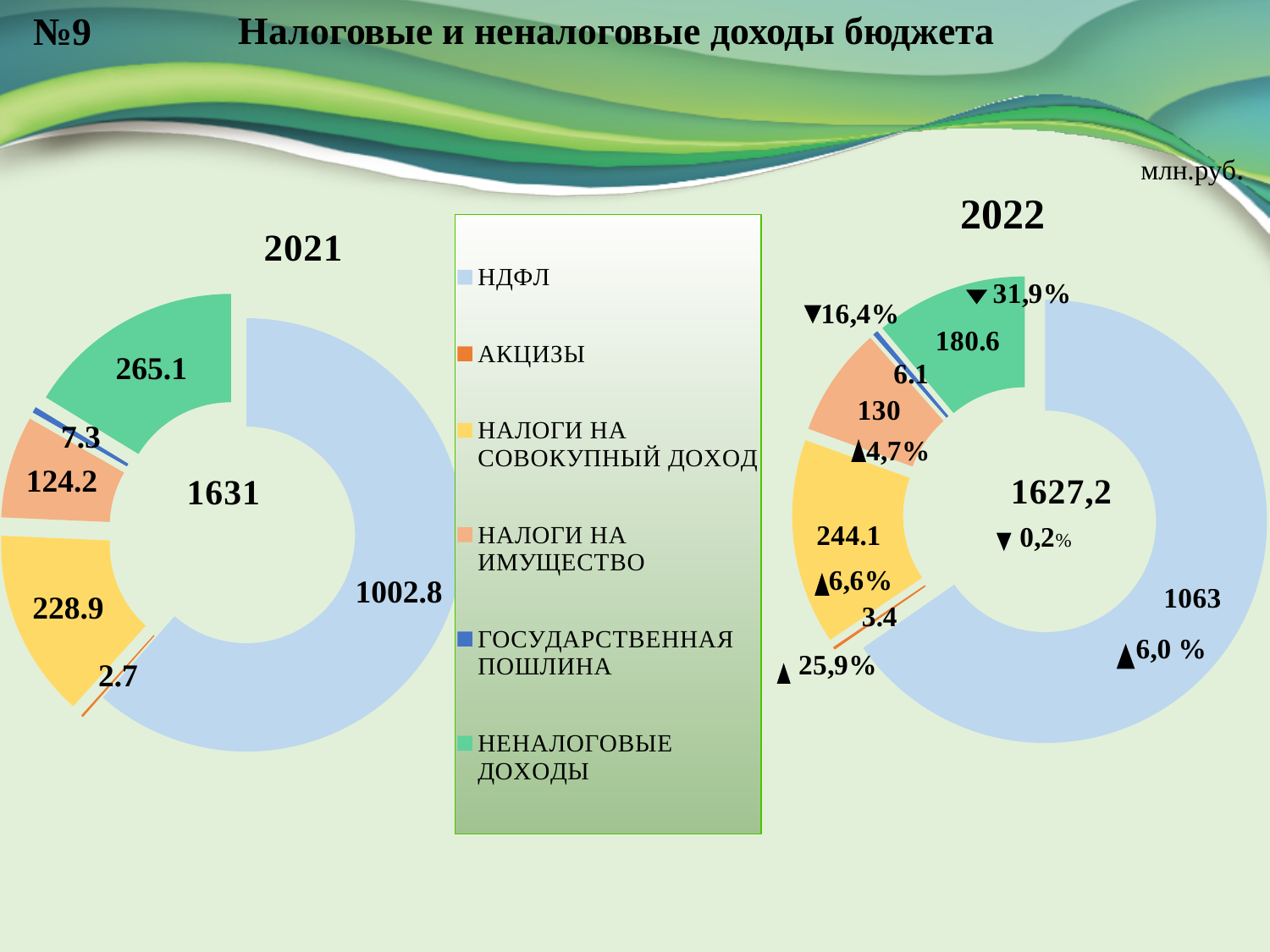
How many entries does the legend list? 6 What kind of chart is the 2021 chart? Doughnut chart On the 2022 chart, what is the value for НАЛОГИ НА СОВОКУПНЫЙ ДОХОД? 244.1 On the 2021 chart, what is the value for НДФЛ? 1002.8 On the 2022 chart, what is the value for НЕНАЛОГОВЫЕ ДОХОДЫ? 180.6 What total is shown in the centre of the 2022 chart? 1627,2 On the 2022 chart, which category has the smallest value? АКЦИЗЫ On the 2021 chart, what is the value for НАЛОГИ НА ИМУЩЕСТВО? 124.2 On the 2021 chart, which category has the largest value? НДФЛ How many categories does the 2022 chart show? 6 Which is larger on the 2021 chart: НАЛОГИ НА СОВОКУПНЫЙ ДОХОД or НЕНАЛОГОВЫЕ ДОХОДЫ? НЕНАЛОГОВЫЕ ДОХОДЫ What is the difference between the НДФЛ value on the 2022 chart and the НДФЛ value on the 2021 chart? 60.2